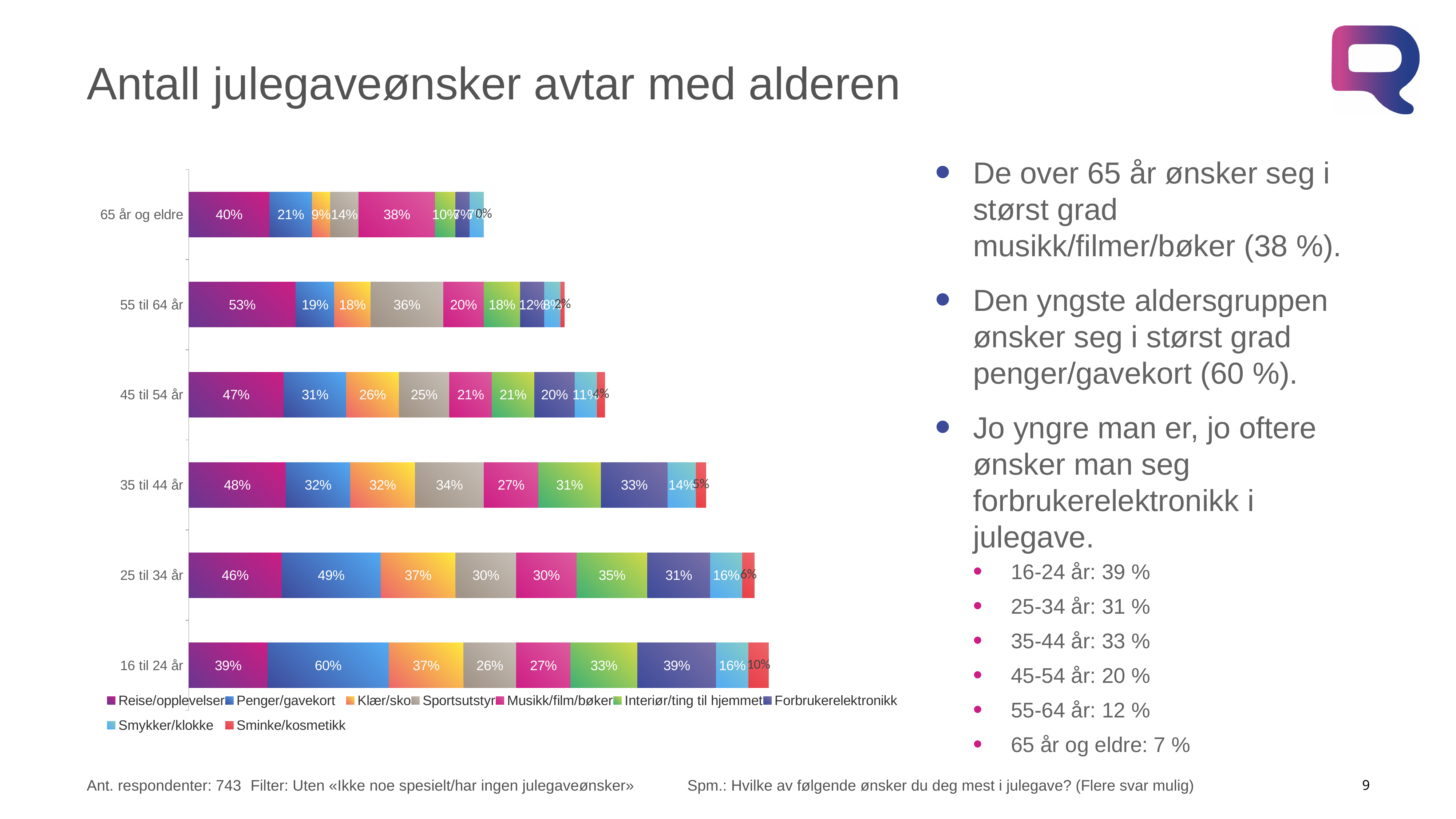
What is the value for Forbrukerelektronikk in the 45 til 54 år group? 20% Which age group has the highest value for Reise/opplevelser? 55 til 64 år How many age groups are shown in the chart? 6 What kind of chart is shown on the slide? Stacked bar chart How many series does the legend list? 9 Which age group has the highest value for Penger/gavekort? 16 til 24 år Which age group has the lowest value for Sminke/kosmetikk? 65 år og eldre What is the value for Sportsutstyr in the 55 til 64 år group? 36% What is the value for Musikk/film/bøker in the 65 år og eldre group? 38% What percentage of the 16 til 24 år group wants Penger/gavekort? 60% Which is larger for the 35 til 44 år group: Sportsutstyr or Musikk/film/bøker? Sportsutstyr What is the difference between the Penger/gavekort values for 16 til 24 år and 25 til 34 år? 11 percentage points